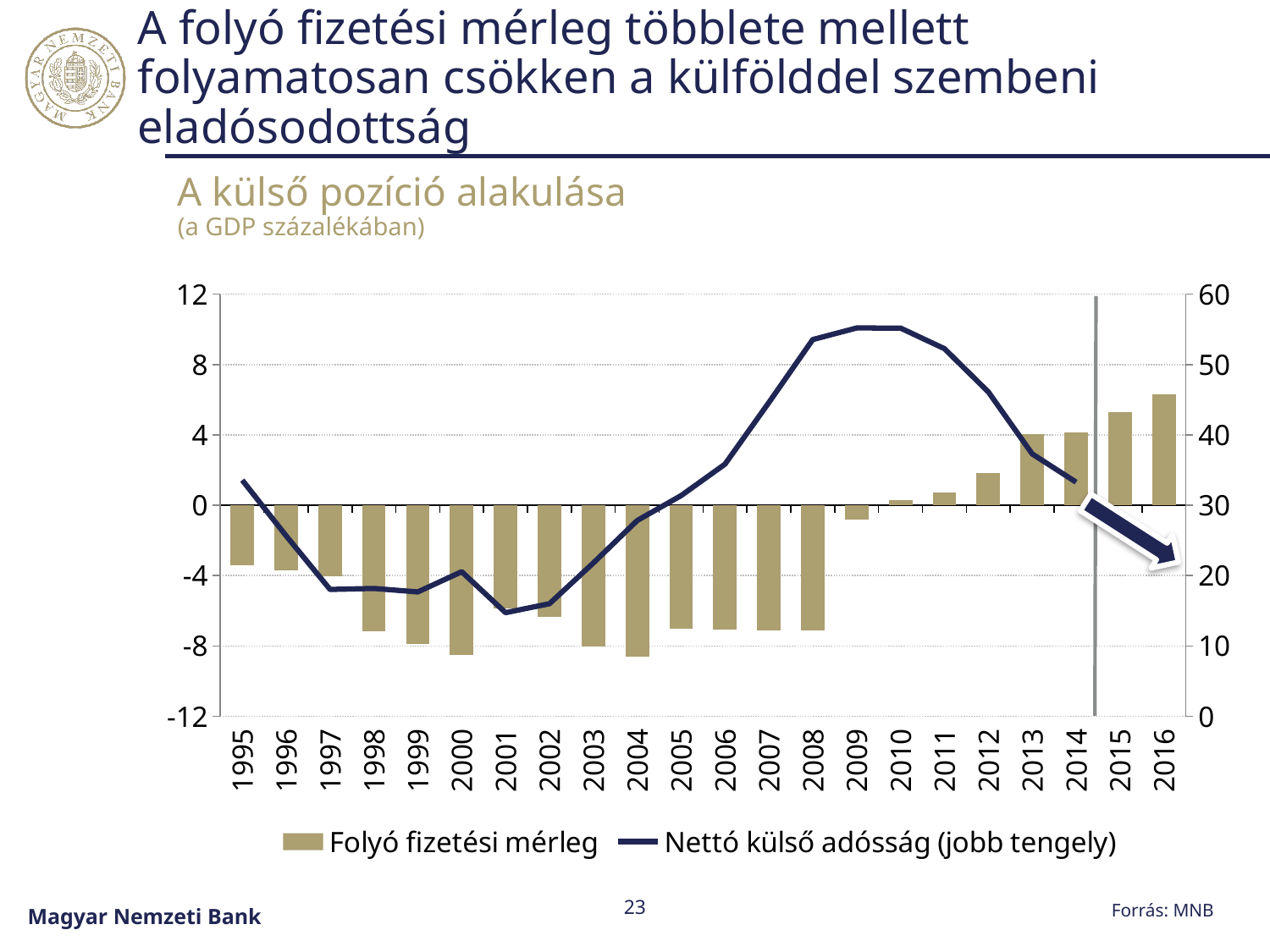
Is the Folyó fizetési mérleg value for 2016 greater or less than 4? greater Is the Nettó külső adósság value for 2010 greater or less than 50 on the right axis? greater Does the Nettó külső adósság line rise or fall between 2010 and 2014? It falls How many series does the legend list? 2 Which year has the highest Folyó fizetési mérleg bar? 2016 Which is larger, the Folyó fizetési mérleg bar for 2013 or for 2015? 2015 Which is higher, the Nettó külső adósság value in 2008 or in 2012? 2008 How many years are shown on the x axis? 22 What kind of chart is shown on the slide? A combined bar and line chart Which series is plotted on the right axis according to the legend? Nettó külső adósság Is the Nettó külső adósság value for 2001 greater or less than 20 on the right axis? less